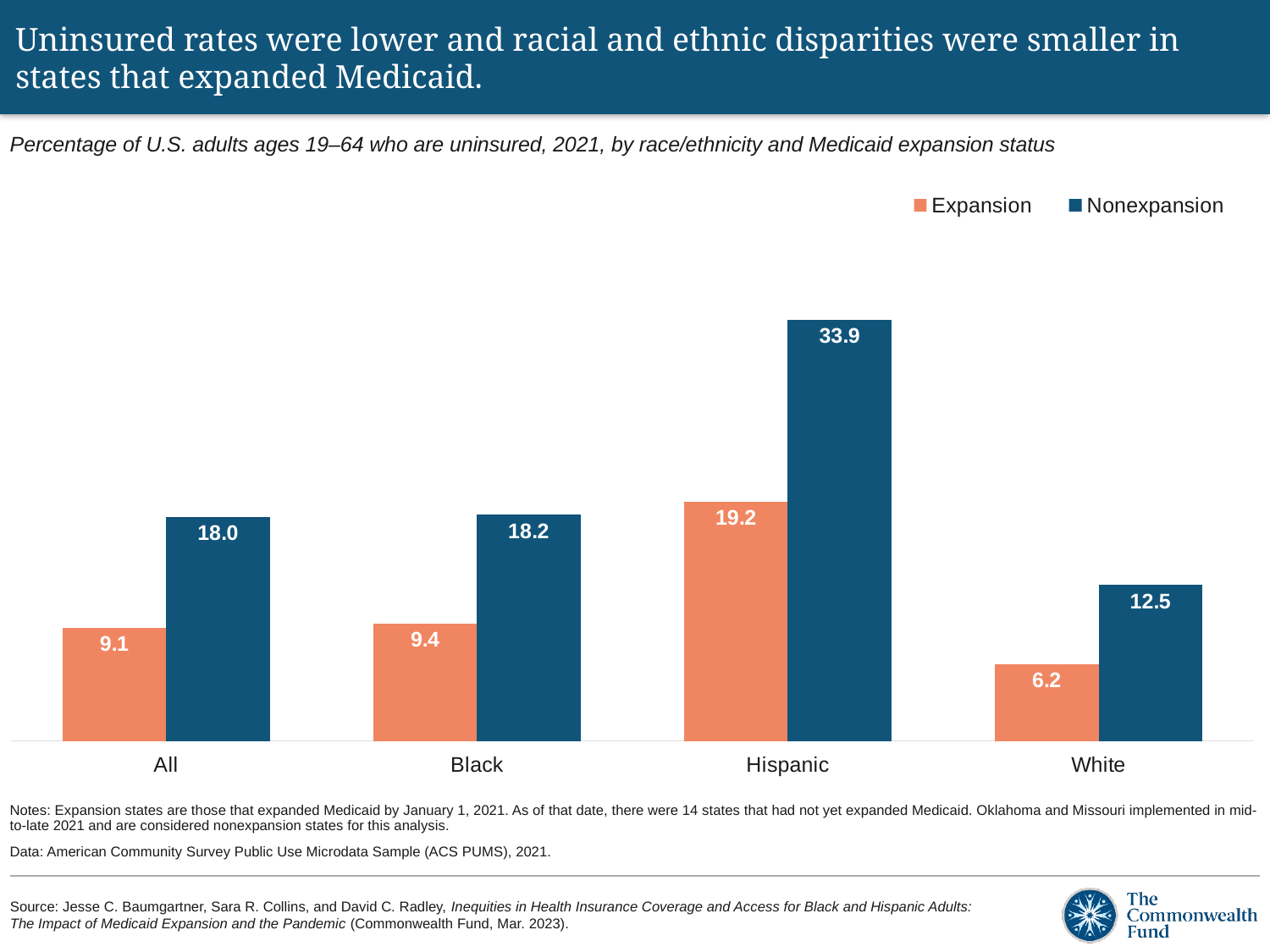
What is the difference between the nonexpansion and expansion uninsured rates for the All category? 8.9 Which colour represents the Nonexpansion series in the legend? Dark blue Which is larger: the expansion rate for Hispanic adults or the nonexpansion rate for White adults? Expansion rate for Hispanic adults How many series does the legend list? 2 What is the uninsured rate for Black adults in expansion states? 9.4 Which race/ethnicity category has the lowest uninsured rate in expansion states? White What kind of chart is shown on the slide? Bar chart Which race/ethnicity category has the highest uninsured rate in nonexpansion states? Hispanic What is the uninsured rate for Hispanic adults in nonexpansion states? 33.9 What is the difference between the nonexpansion and expansion uninsured rates for Hispanic adults? 14.7 How many race/ethnicity categories are shown on the x axis? 4 What is the uninsured rate for White adults in expansion states? 6.2